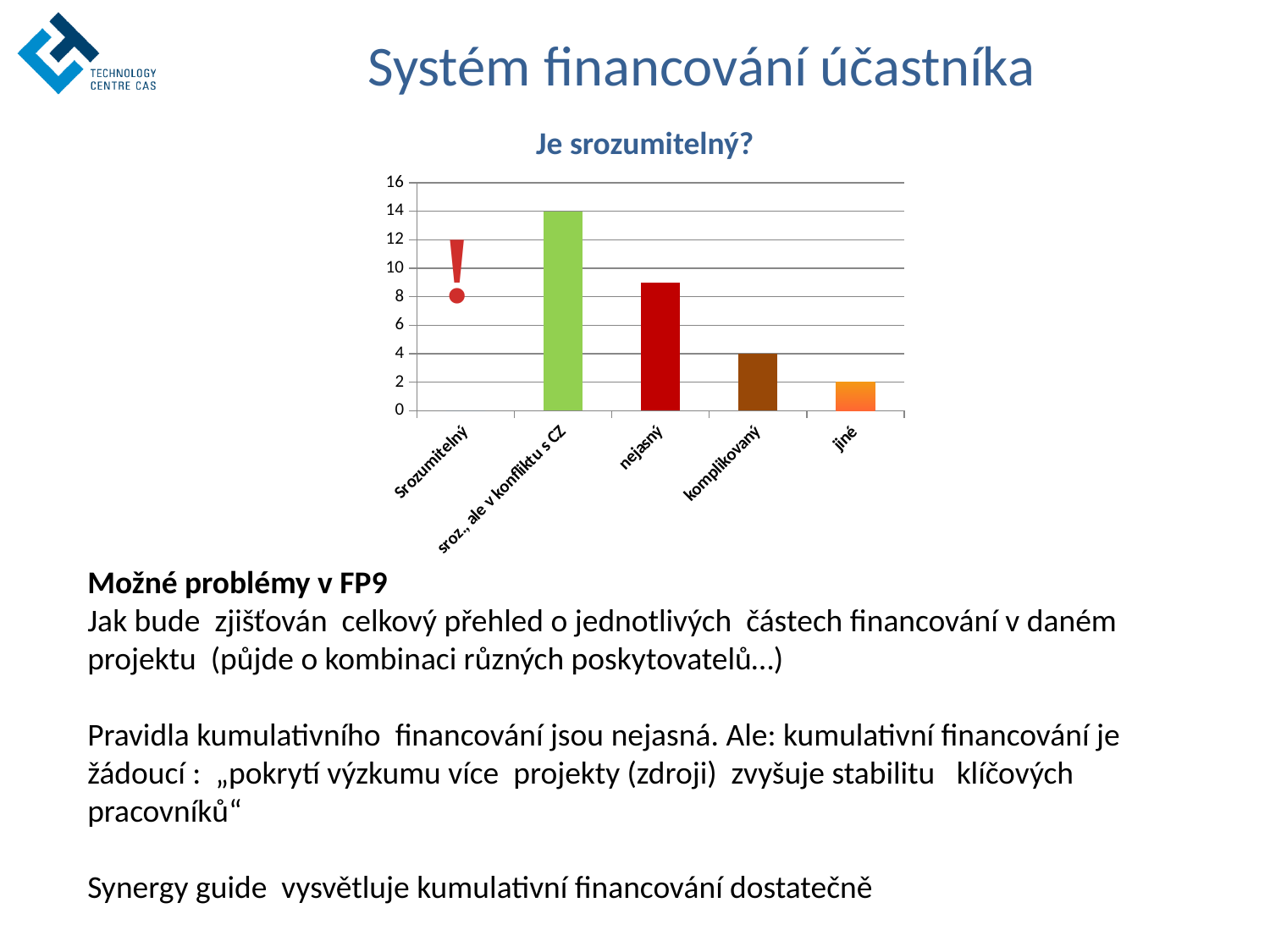
What is the difference between the values for 'komplikovaný' and 'jiné'? 2 Is the value for 'nejasný' greater or less than 10? less How many categories are shown on the x axis of the chart? 5 Is the value for 'nejasný' greater or less than 8? greater What kind of chart is shown on the slide? bar chart What is the value for 'sroz., ale v konfliktu s CZ' in the chart 'Je srozumitelný?' 14 What is the title of the chart on the slide? Je srozumitelný? What is the value for 'komplikovaný' in the chart 'Je srozumitelný?' 4 What is the difference between the values for 'sroz., ale v konfliktu s CZ' and 'komplikovaný'? 10 Which has a larger value, 'nejasný' or 'komplikovaný'? nejasný What is the value for 'jiné' in the chart 'Je srozumitelný?' 2 Which category has the highest value in the chart 'Je srozumitelný?' sroz., ale v konfliktu s CZ